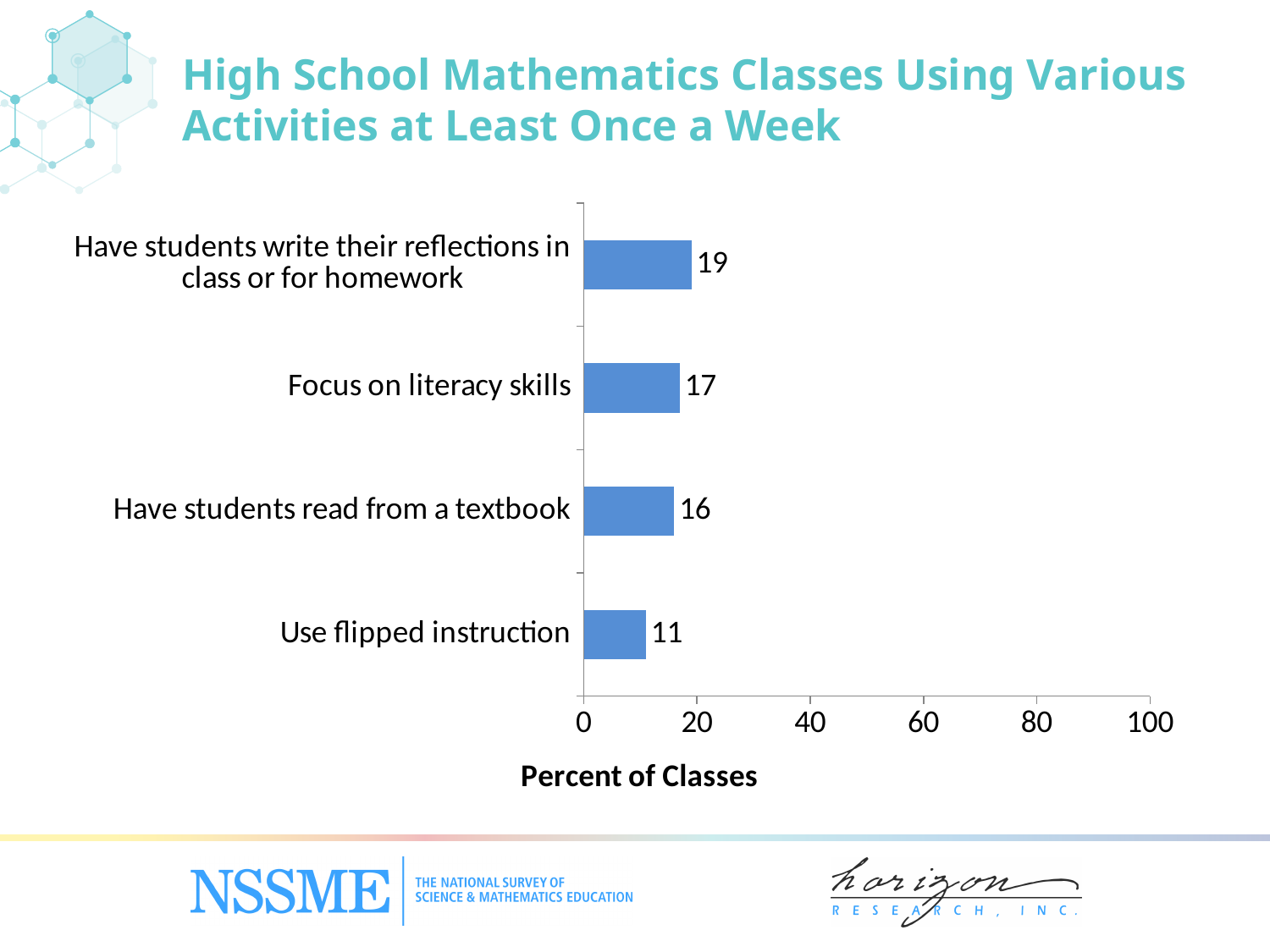
What is the value for 'Use flipped instruction'? 11 What percent of classes have students read from a textbook at least once a week? 16 What is the label of the horizontal axis? Percent of Classes How many activities are shown in the chart? 4 What percent of classes have students write their reflections in class or for homework at least once a week? 19 What kind of chart is shown on the slide? Bar chart Is the value for 'Use flipped instruction' greater or less than 20? less Which is larger: the value for 'Focus on literacy skills' or 'Have students read from a textbook'? Focus on literacy skills What is the difference between the values for 'Have students write their reflections in class or for homework' and 'Use flipped instruction'? 8 Which activity has the lowest percent of classes? Use flipped instruction Which activity has the highest percent of classes? Have students write their reflections in class or for homework What is the value for 'Focus on literacy skills'? 17